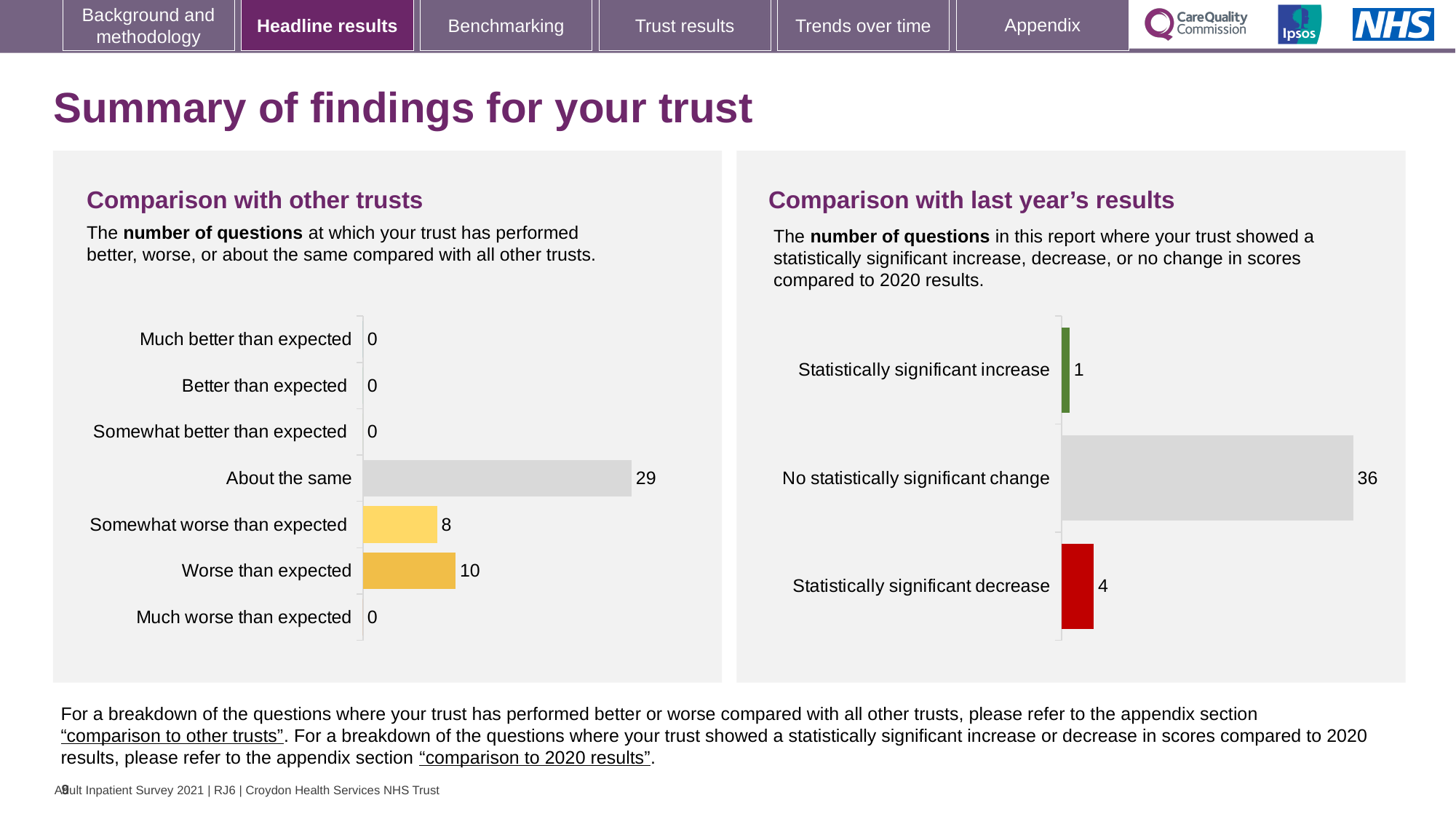
In the 'Comparison with other trusts' chart, what is the value for 'Somewhat worse than expected'? 8 In the 'Comparison with other trusts' chart, which category has the highest value? About the same In the 'Comparison with other trusts' chart, how many categories have a value of 0? 4 In the 'Comparison with other trusts' chart, how many categories are shown? 7 In the 'Comparison with other trusts' chart, what is the difference between 'About the same' and 'Worse than expected'? 19 In the 'Comparison with other trusts' chart, what is the value for 'Worse than expected'? 10 In the 'Comparison with last year's results' chart, what is the total of all three categories? 41 In the 'Comparison with other trusts' chart, what is the value for 'About the same'? 29 In the 'Comparison with last year's results' chart, what is the value for 'Statistically significant decrease'? 4 In the 'Comparison with last year's results' chart, what is the value for 'No statistically significant change'? 36 In the 'Comparison with last year's results' chart, which category has the lowest value? Statistically significant increase What type of chart is used in the 'Comparison with last year's results' panel? Bar chart